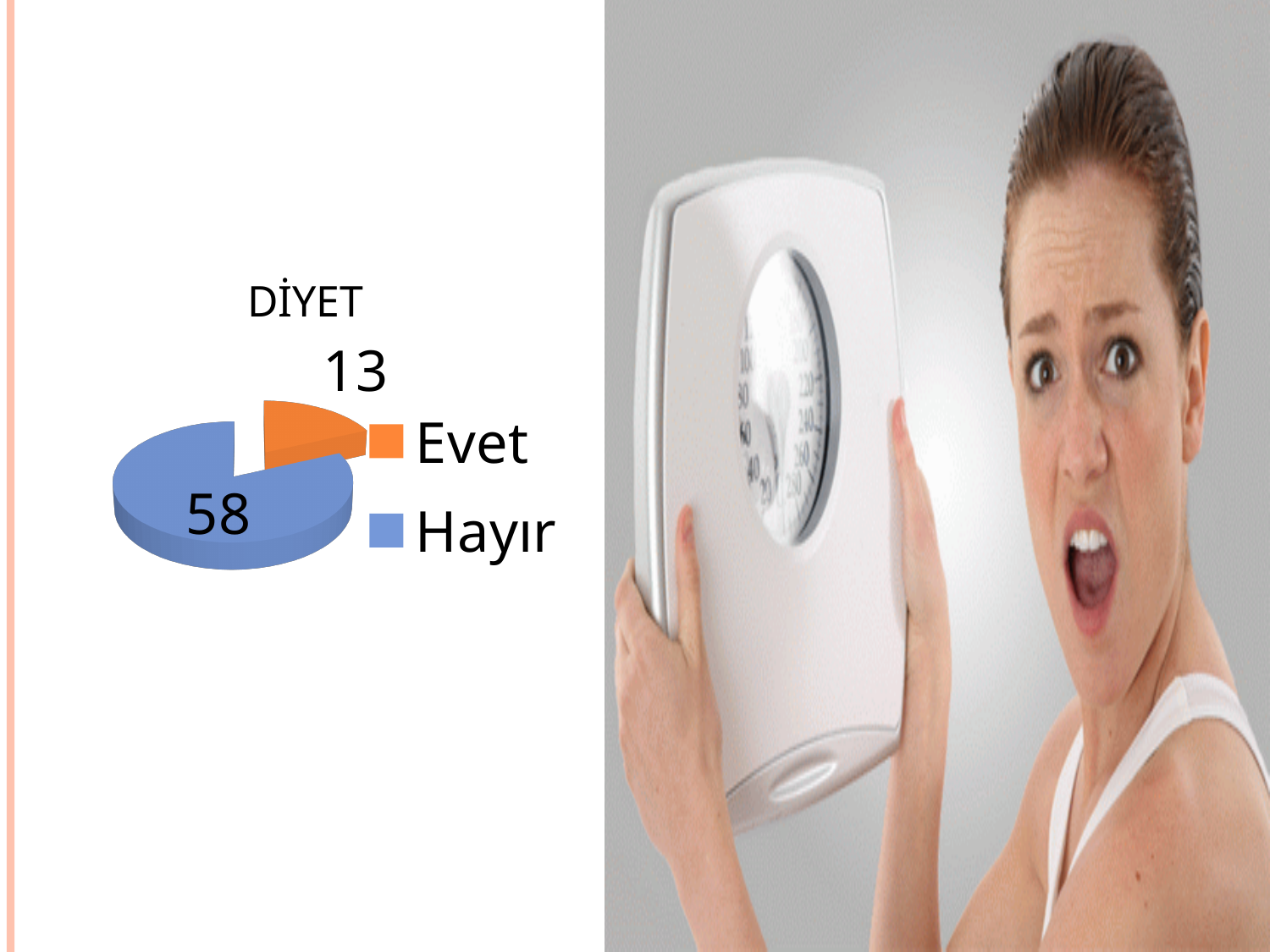
What colour is the Evet slice in the DİYET pie chart? Orange What is the title of the chart on the slide? DİYET Which category has the smallest slice in the DİYET pie chart? Evet What is the value for Evet in the DİYET pie chart? 13 Which is larger in the DİYET chart, Evet or Hayır? Hayır What kind of chart is shown on the slide? Pie chart What is the total of the two values in the DİYET pie chart? 71 How many categories does the DİYET pie chart show? 2 Which category has the largest slice in the DİYET pie chart? Hayır What is the difference between the Hayır and Evet values in the DİYET chart? 45 What is the value for Hayır in the DİYET pie chart? 58